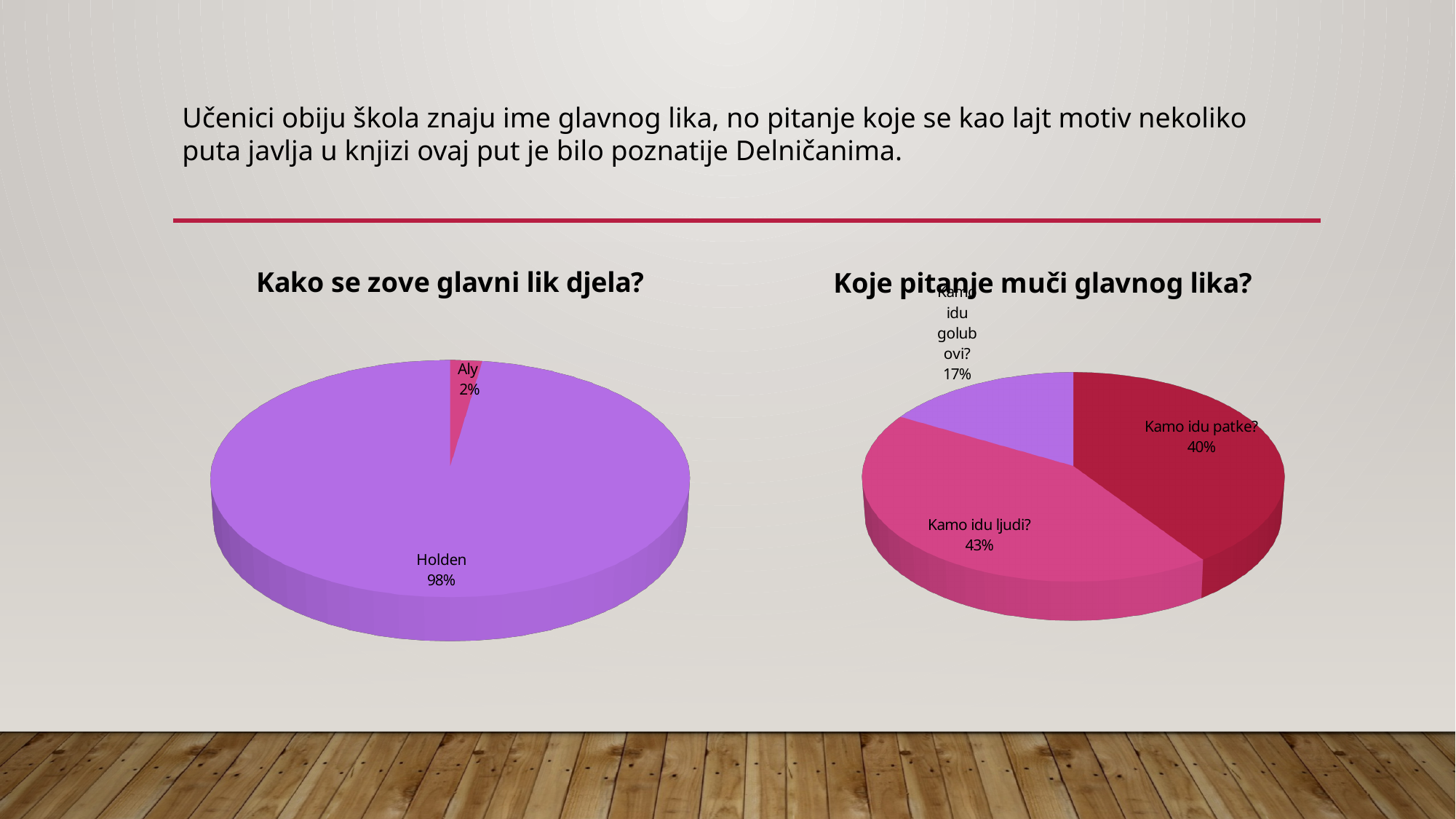
In the chart titled "Koje pitanje muči glavnog lika?", how many slices does the pie have? 3 In the chart titled "Koje pitanje muči glavnog lika?", what is the difference between the shares of "Kamo idu ljudi?" and "Kamo idu golubovi?"? 26% In the chart titled "Koje pitanje muči glavnog lika?", what share does "Kamo idu patke?" have? 40% In the chart titled "Koje pitanje muči glavnog lika?", what share does "Kamo idu ljudi?" have? 43% What kind of chart is the chart titled "Kako se zove glavni lik djela?"? Pie chart In the chart titled "Kako se zove glavni lik djela?", which slice is the largest? Holden In the chart titled "Kako se zove glavni lik djela?", what share does Holden have? 98% In the chart titled "Koje pitanje muči glavnog lika?", which slice is the smallest? Kamo idu golubovi? In the chart titled "Kako se zove glavni lik djela?", how many slices does the pie have? 2 In the chart titled "Koje pitanje muči glavnog lika?", which slice is the largest? Kamo idu ljudi?